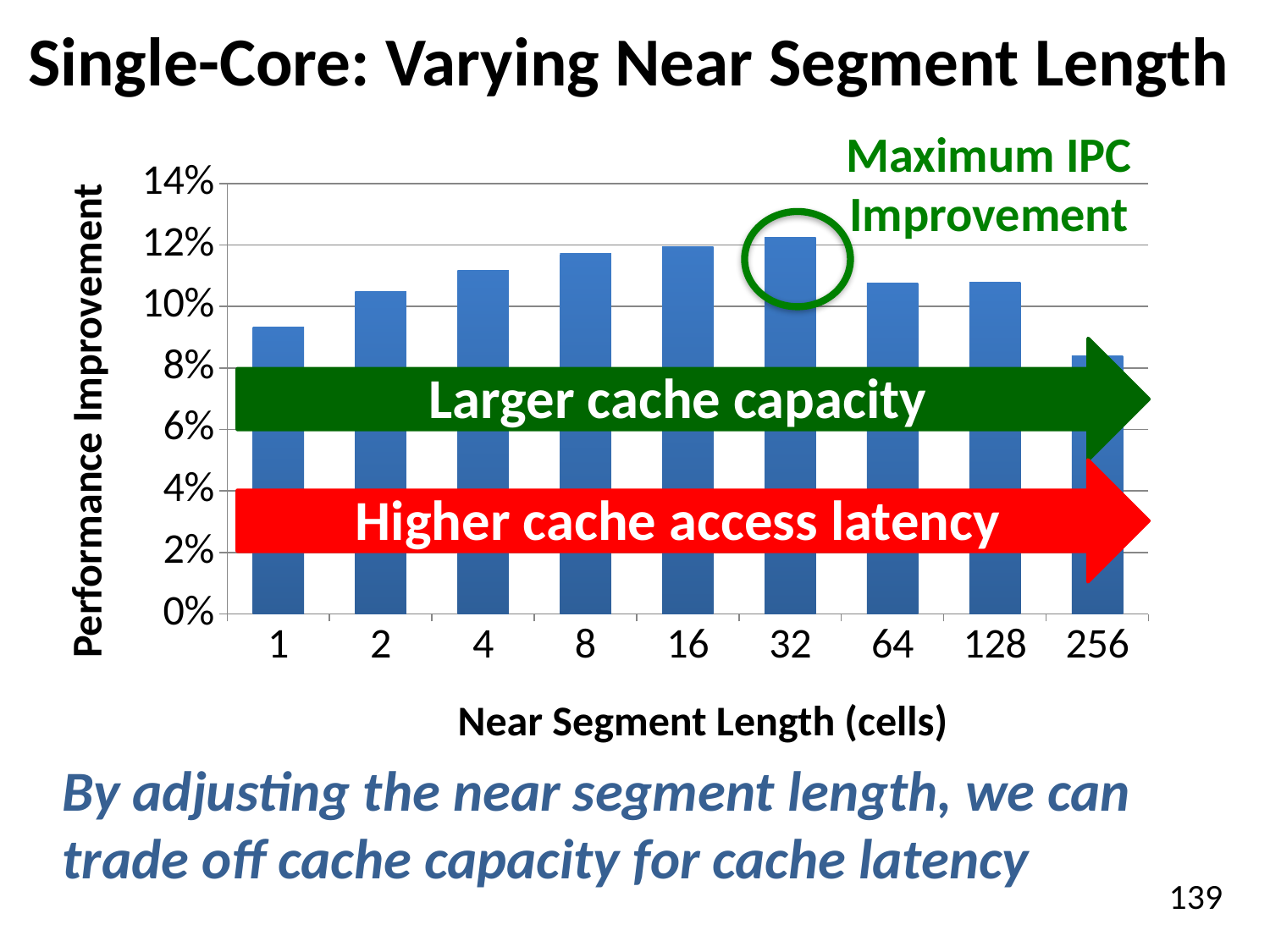
Which near segment length gives the lowest performance improvement? 256 Which has the larger performance improvement: a near segment length of 1 or 8? 8 Is the performance improvement for a near segment length of 4 greater or less than 10%? greater How does the performance improvement change as the near segment length increases from 1 to 32? It rises Which near segment length gives the highest performance improvement? 32 Is the performance improvement for a near segment length of 1 greater or less than 8%? greater How many near segment lengths are plotted on the x axis? 9 What is the label of the x axis? Near Segment Length (cells) Is the performance improvement for a near segment length of 64 greater or less than 10%? greater Which has the larger performance improvement: a near segment length of 32 or 256? 32 What kind of chart is shown on the slide? bar chart